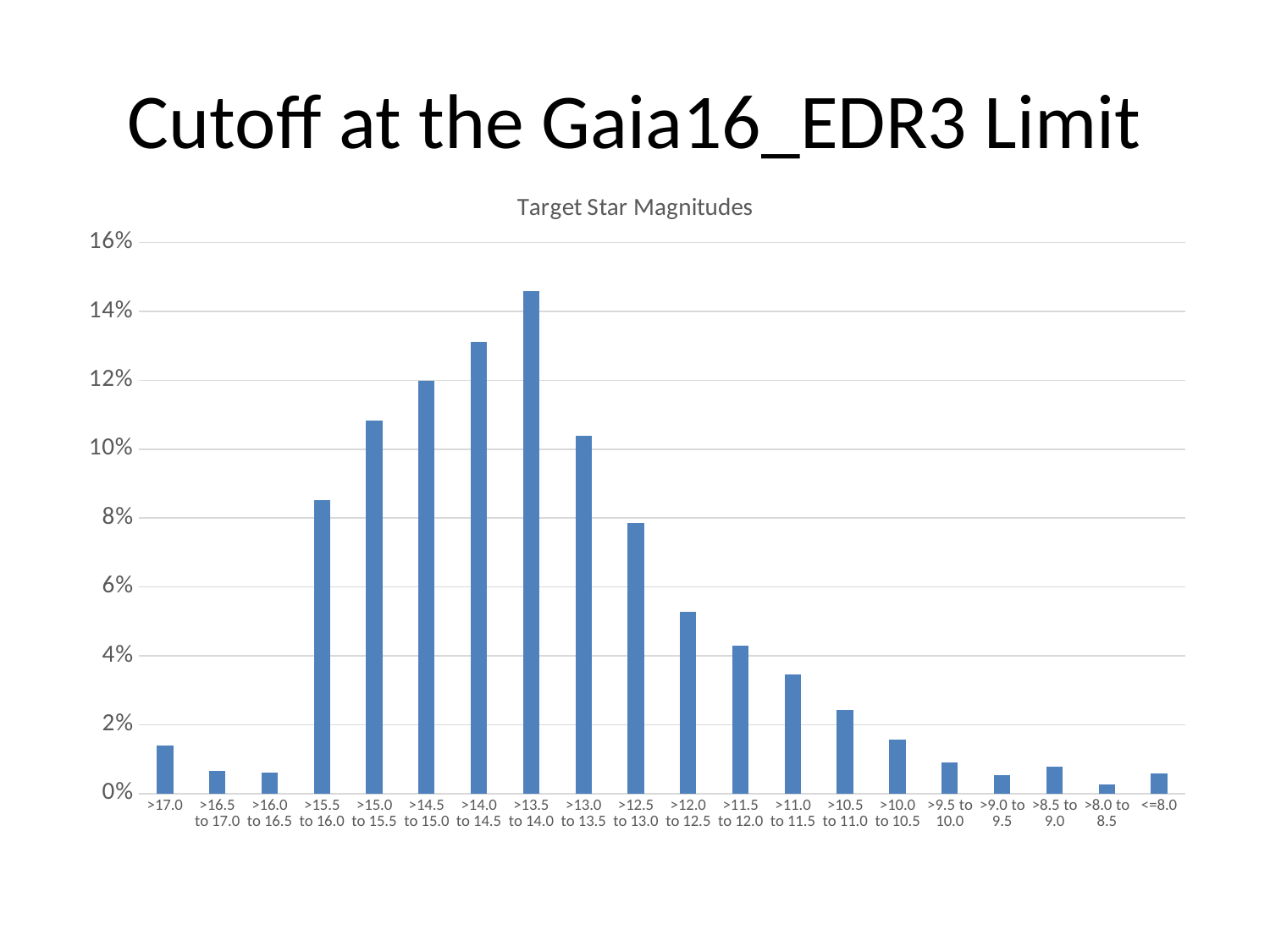
Is the value for the >17.0 bin greater or less than 2%? less What kind of chart is shown on the slide? bar chart What is the title of the chart? Target Star Magnitudes Is the value for the >11.0 to 11.5 bin greater or less than 4%? less Which magnitude bin has the highest percentage of target stars? >13.5 to 14.0 Is the value for the >15.5 to 16.0 bin greater or less than 8%? greater Moving from the >13.5 to 14.0 bin rightward to the <=8.0 bin, do the values generally rise or fall? fall Which magnitude bin has the lowest percentage of target stars? >8.0 to 8.5 How many magnitude bins (categories) are plotted on the x axis? 20 Which bin has a larger value, >14.0 to 14.5 or >13.0 to 13.5? >14.0 to 14.5